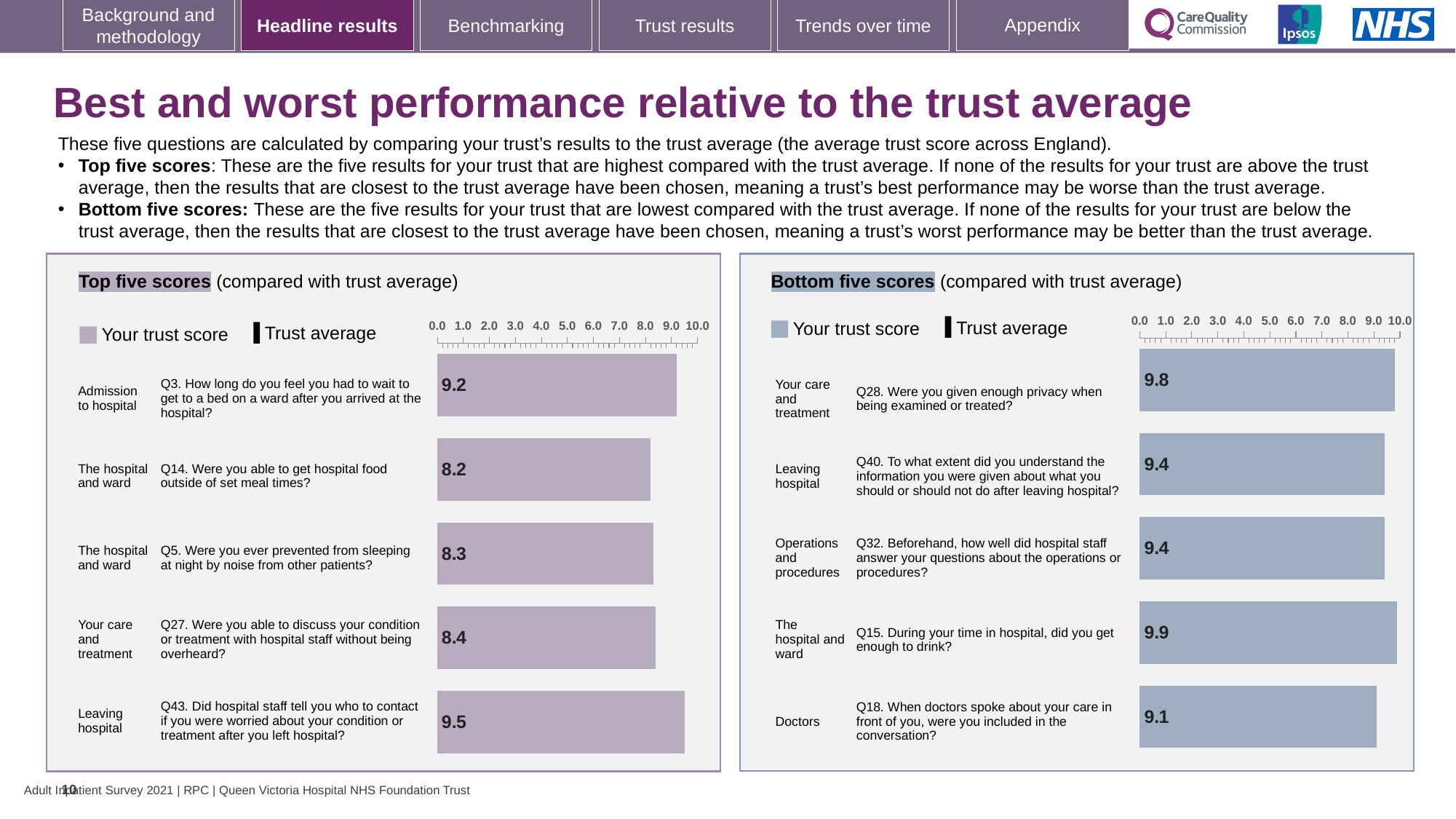
In the Bottom five scores chart, which question has the lowest trust score? Q18 In the Bottom five scores chart, what is the difference between the scores for Q15 and Q18? 0.8 In the Top five scores chart, which has the larger score: Q27 or Q5? Q27 How many questions are shown in the Bottom five scores chart? 5 In the Top five scores chart, what is the trust score for Q3 (how long you had to wait to get to a bed on a ward)? 9.2 In the Top five scores chart, which question has the highest trust score? Q43 In the Bottom five scores chart, what is the trust score for Q18 (were you included in the conversation when doctors spoke about your care)? 9.1 In the Top five scores chart, what is the trust score for Q14 (able to get hospital food outside of set meal times)? 8.2 What kind of chart is the Top five scores chart? Bar chart In the Top five scores chart, which question has the lowest trust score? Q14 In the Bottom five scores chart, what is the trust score for Q15 (did you get enough to drink)? 9.9 How many series does the legend of the Top five scores chart list? 2